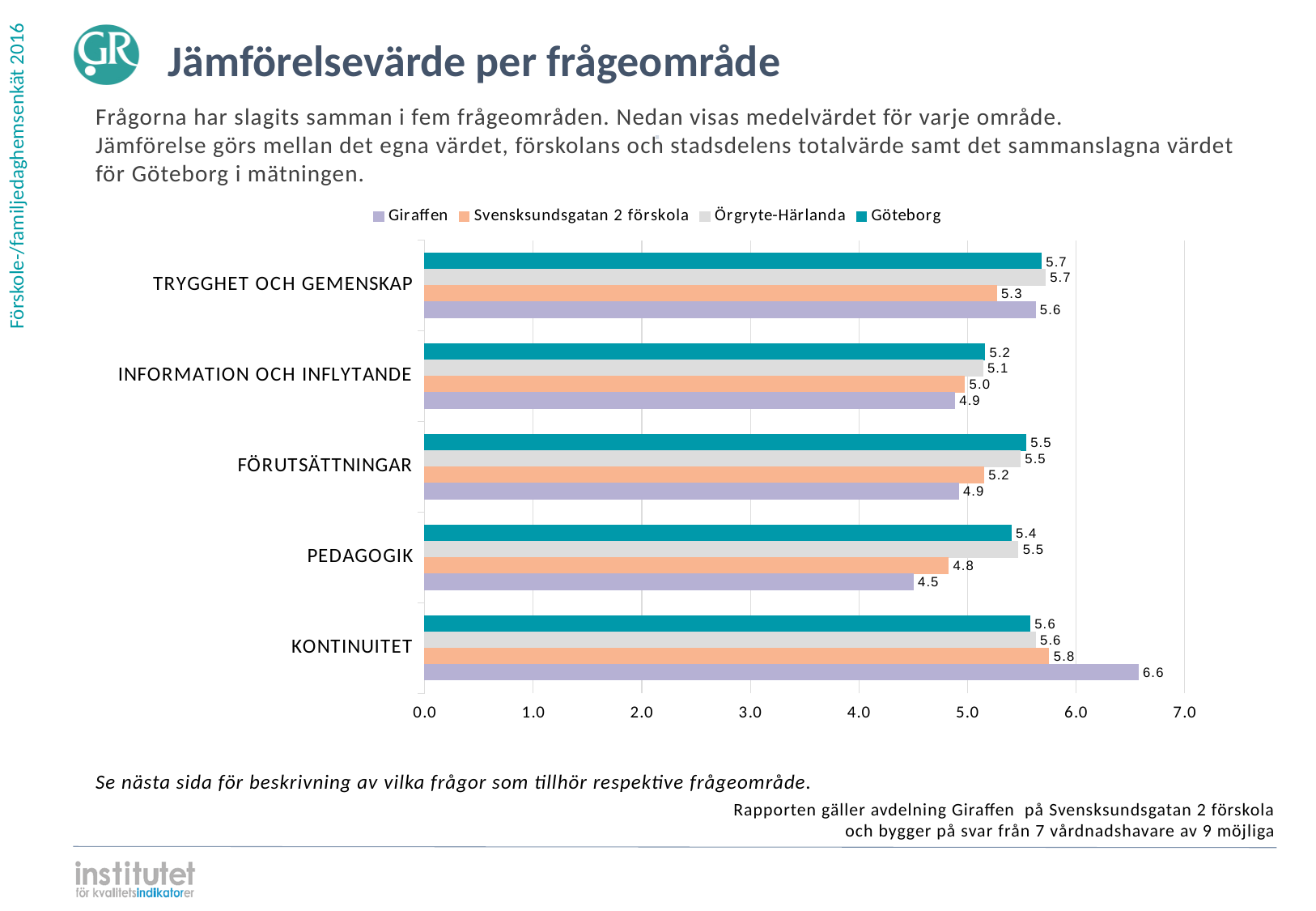
How many question areas (categories) are shown on the chart? 5 How many series does the legend list? 4 What type of chart is shown on the slide? bar chart Is the value for Giraffen in the PEDAGOGIK category greater or less than 5.0? less In which category does Giraffen have its highest value? KONTINUITET What is the value for Göteborg in the INFORMATION OCH INFLYTANDE category? 5.2 What is the value for Svensksundsgatan 2 förskola in the PEDAGOGIK category? 4.8 What is the maximum value shown on the horizontal axis? 7.0 In which category does Giraffen have its lowest value? PEDAGOGIK In the PEDAGOGIK category, which is larger: the value for Örgryte-Härlanda or the value for Giraffen? Örgryte-Härlanda What is the value for Giraffen in the KONTINUITET category? 6.6 What is the difference between the Giraffen value and the Göteborg value in the KONTINUITET category? 1.0